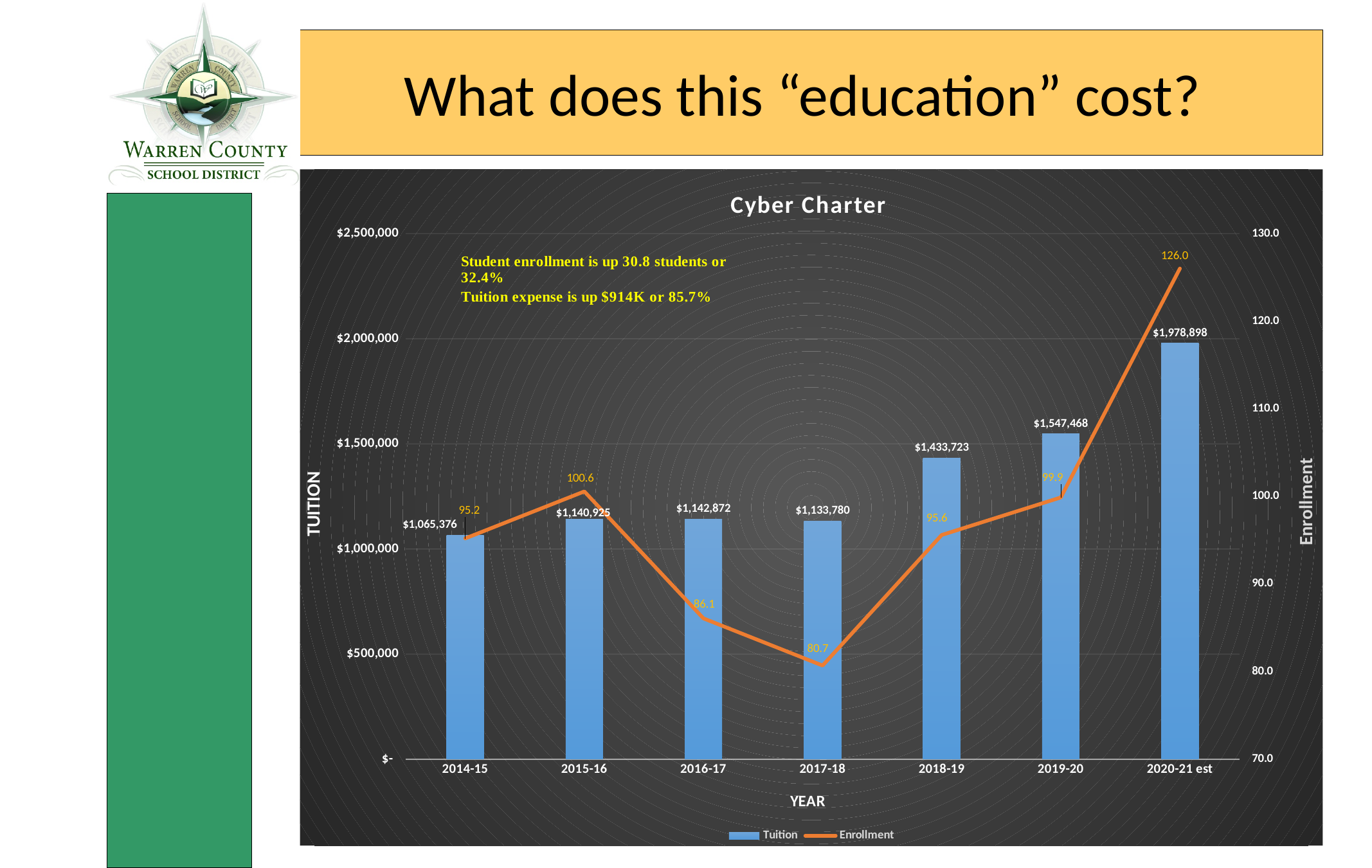
How many years are shown on the x axis? 7 Is the Tuition for 2019-20 greater or less than $1,500,000? greater What is the Enrollment value for 2016-17? 86.1 What is the difference in Enrollment between 2015-16 and 2014-15? 5.4 Which year has the highest Tuition? 2020-21 est Which year has the lowest Enrollment? 2017-18 What is the Tuition value for 2020-21 est? $1,978,898 How many series does the legend list? 2 What is the Tuition value for 2018-19? $1,433,723 What is the title of the chart? Cyber Charter What is the difference in Tuition between 2020-21 est and 2019-20? $431,430 Which year has the lowest Tuition? 2014-15